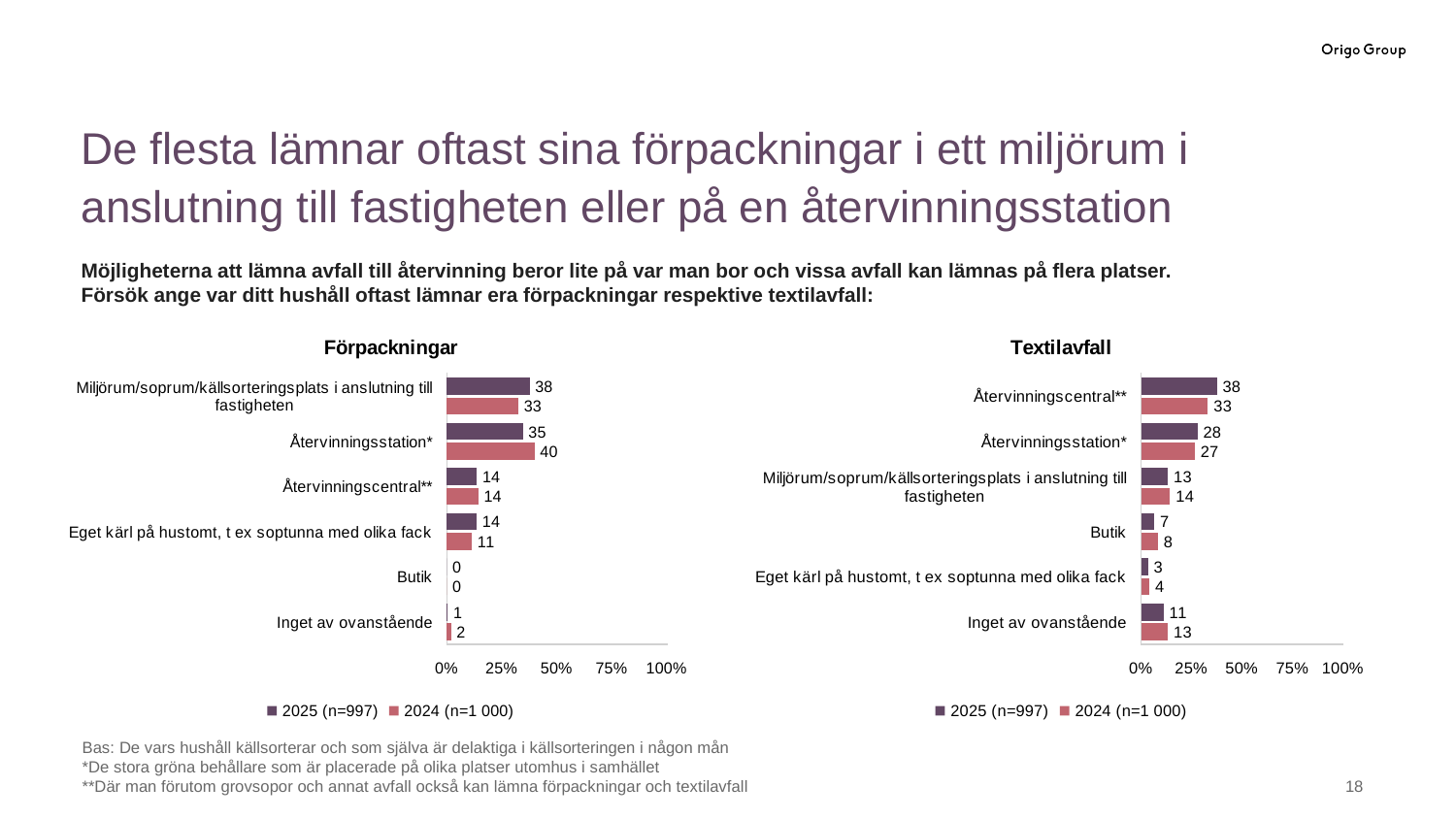
In the Förpackningar chart, what is the difference between the 2024 (n=1 000) and 2025 (n=997) values for Återvinningsstation*? 5 In the Textilavfall chart, what is the 2024 (n=1 000) value for Butik? 8 In the Förpackningar chart, which category has the highest 2024 (n=1 000) value? Återvinningsstation* In the Textilavfall chart, which category has the lowest 2025 (n=997) value? Eget kärl på hustomt, t ex soptunna med olika fack How many series does the legend of the Textilavfall chart list? 2 In the Förpackningar chart, what is the 2025 (n=997) value for Återvinningsstation*? 35 In the Textilavfall chart, which is larger for Återvinningscentral**: the 2025 (n=997) value or the 2024 (n=1 000) value? 2025 (n=997) In the Förpackningar chart, what is the 2024 (n=1 000) value for Eget kärl på hustomt, t ex soptunna med olika fack? 11 What type of chart is the Förpackningar chart? Bar chart In the Textilavfall chart, is the 2025 (n=997) value for Återvinningscentral** greater or less than 25%? greater How many categories are shown in the Förpackningar chart? 6 In the Textilavfall chart, what is the 2025 (n=997) value for Inget av ovanstående? 11